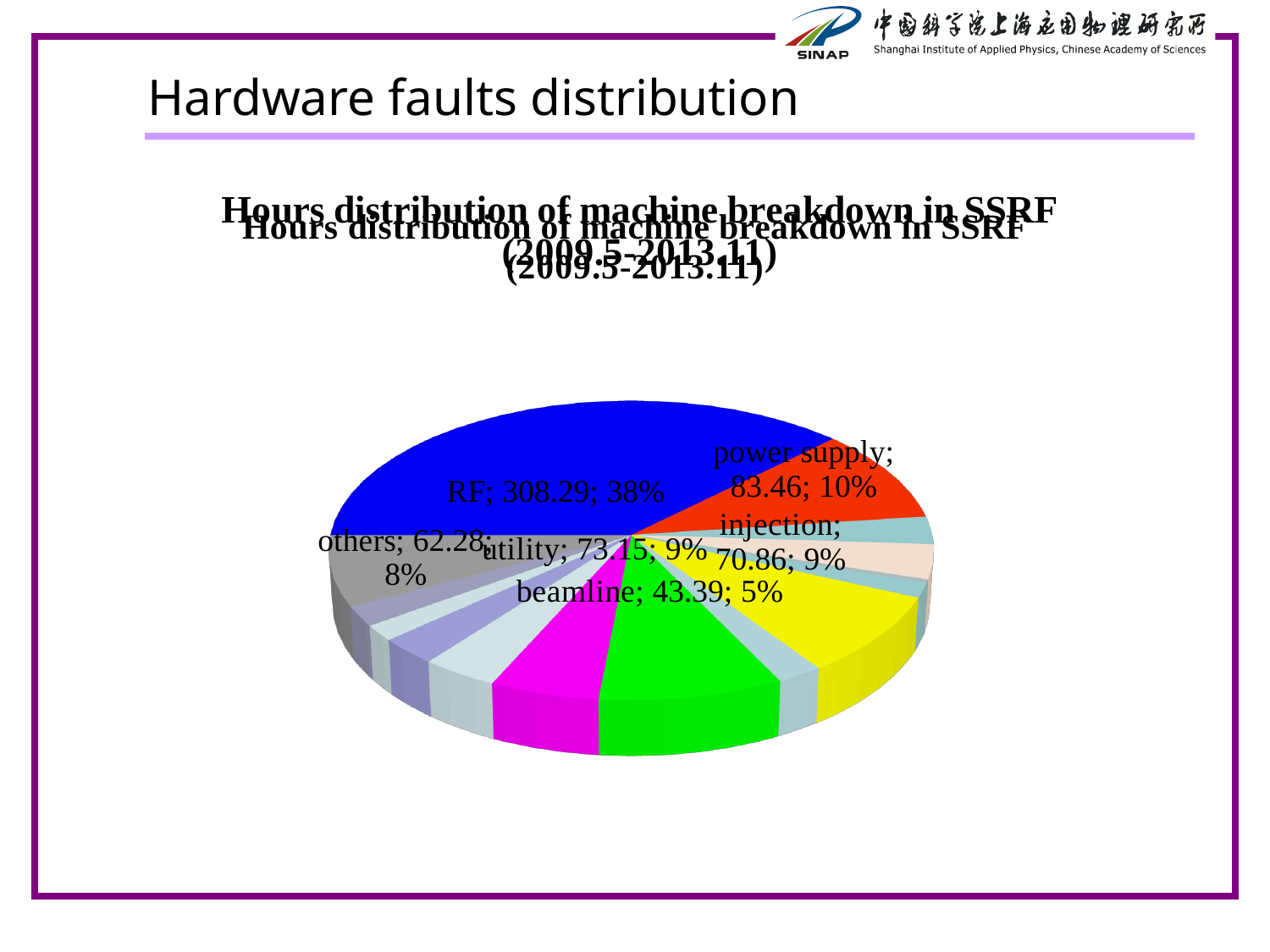
What percentage share of the pie does beamline account for? 5% What percentage share of the pie does RF account for? 38% What is the value shown for RF in the pie chart? 308.29 What is the value shown for power supply in the pie chart? 83.46 What is the difference between the RF value and the power supply value? 224.83 Which is larger, the value for utility or the value for others? utility What is the value shown for injection in the pie chart? 70.86 What is the value shown for utility in the pie chart? 73.15 What type of chart is shown on the slide? pie chart Which labelled category has the largest slice of the pie chart? RF What is the value shown for others in the pie chart? 62.28 What is the value shown for beamline in the pie chart? 43.39